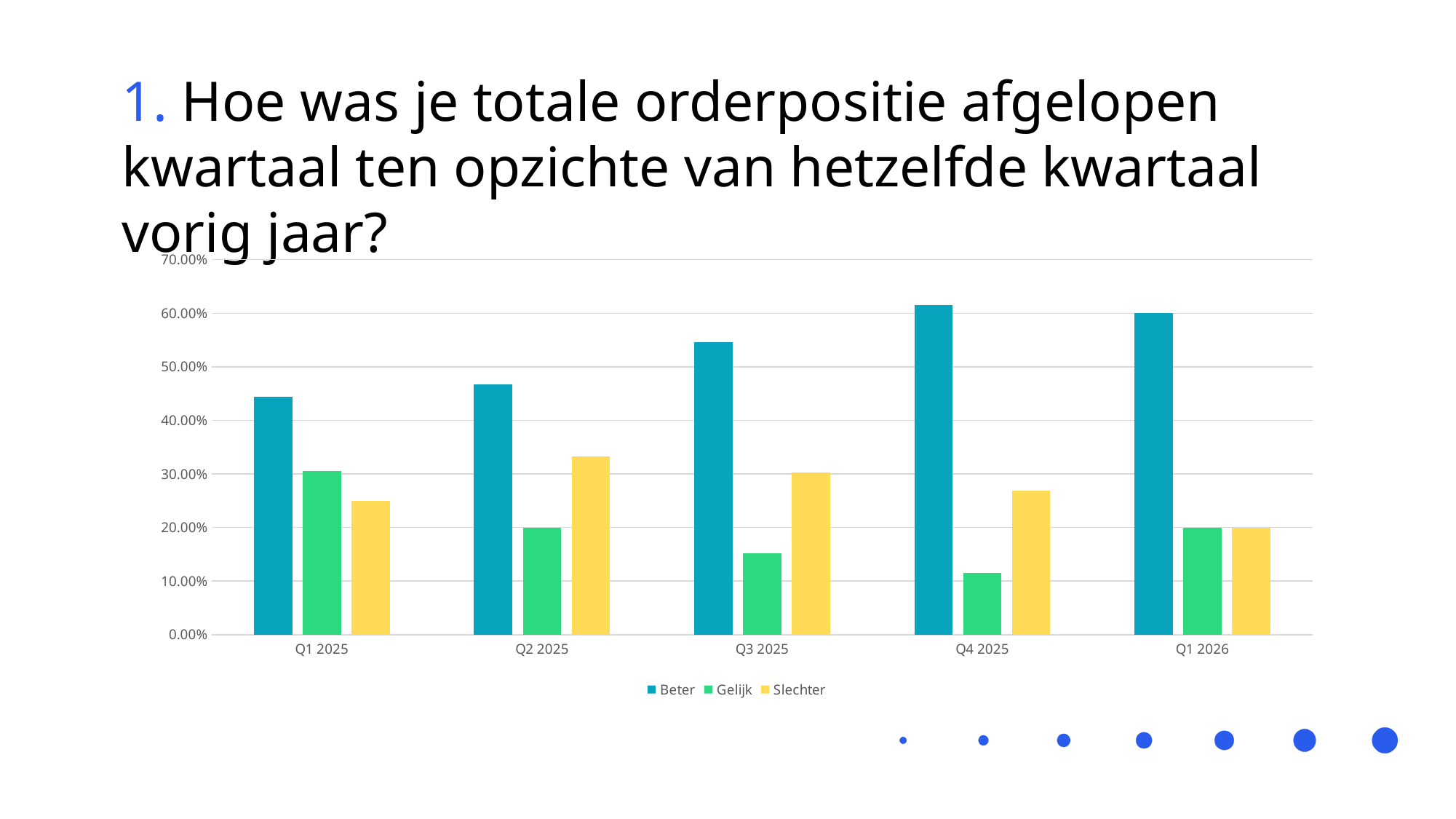
Is the value for Slechter in Q2 2025 greater or less than 30.00%? greater In which quarter is the Gelijk value the lowest? Q4 2025 How many quarters are shown on the x axis of the chart? 5 Does the Beter value rise or fall from Q1 2025 to Q4 2025? Rise What kind of chart is shown on the slide? Bar chart Is the value for Beter in Q3 2025 greater or less than 50.00%? greater In which quarter is the Gelijk value the highest? Q1 2025 In Q2 2025, which is larger: Gelijk or Slechter? Slechter Is the value for Gelijk in Q4 2025 greater or less than 20.00%? less What are the three series listed in the chart's legend? Beter, Gelijk, Slechter How many series does the chart's legend list? 3